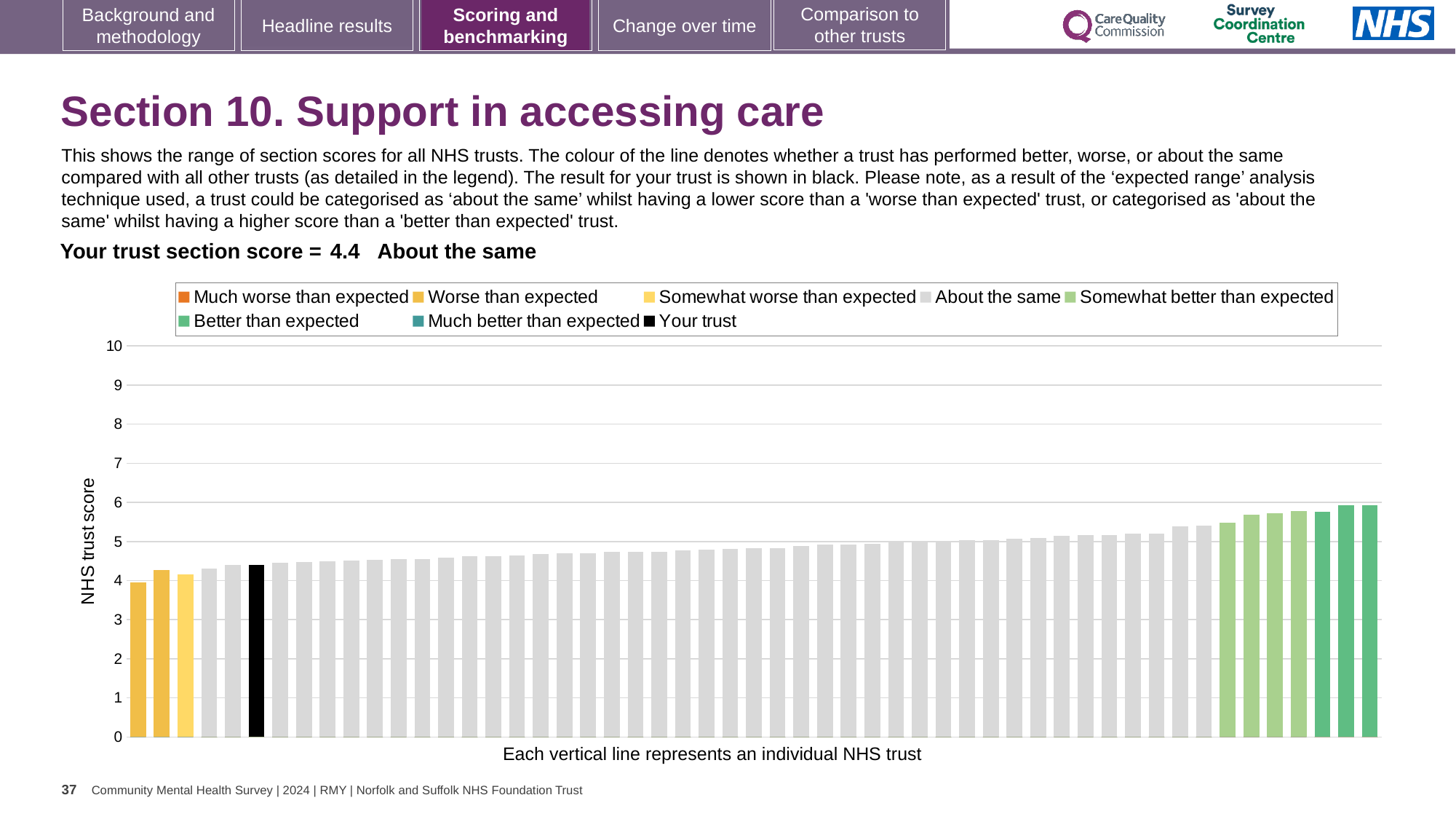
Do the bar values rise or fall from left to right along the x axis? rise What is the label on the y axis of the chart? NHS trust score How many bars are coloured as 'Better than expected'? 3 How many entries does the chart legend list? 8 How many bars are coloured as 'Somewhat worse than expected'? 1 What is the trust's section score shown on the slide? 4.4 Is the value of the shortest bar greater or less than 3? greater What kind of chart is shown on the slide? bar chart Which performance category does the trust's section score fall into? About the same Is the value of the black 'Your trust' bar greater or less than 5? less How many bars are coloured as 'Worse than expected'? 2 Is the value of the tallest bar greater or less than 5? greater